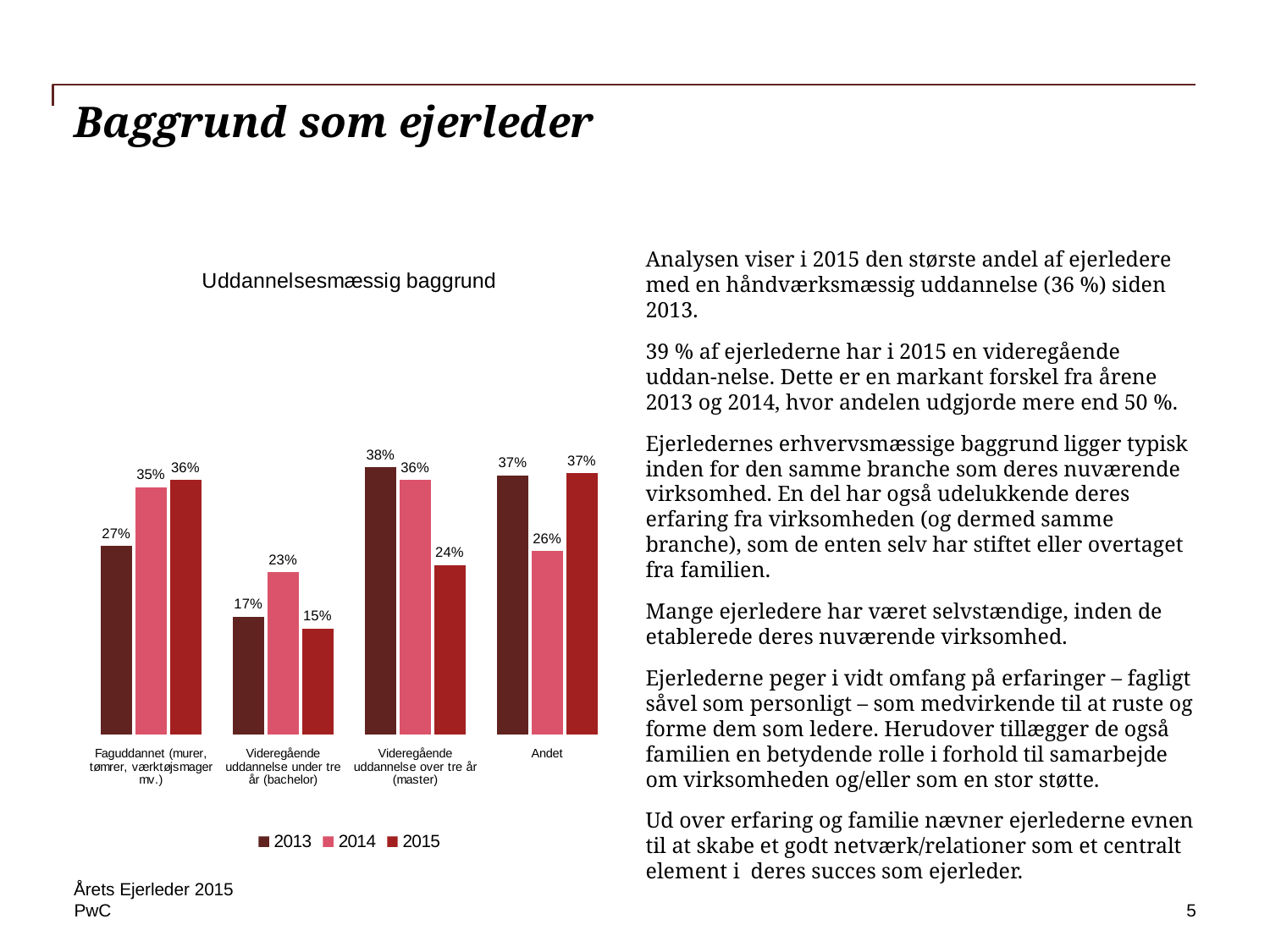
What is the value for 2015 in the Faguddannet (murer, tømrer, værktøjsmager mv.) category? 36% What is the difference between the 2013 and 2015 values in the Videregående uddannelse over tre år (master) category? 14% What is the value for 2014 in the Videregående uddannelse under tre år (bachelor) category? 23% What is the value for 2013 in the Videregående uddannelse over tre år (master) category? 38% What is the value for 2014 in the Andet category? 26% Which category has the lowest value for the 2015 series? Videregående uddannelse under tre år (bachelor) Which is larger in the Faguddannet (murer, tømrer, værktøjsmager mv.) category: the 2013 value or the 2014 value? 2014 Which category has the highest value for the 2013 series? Videregående uddannelse over tre år (master) How many series does the chart legend list? 3 How many categories are shown on the x axis of the chart? 4 What kind of chart is shown on the slide? Bar chart What is the title of the chart? Uddannelsesmæssig baggrund